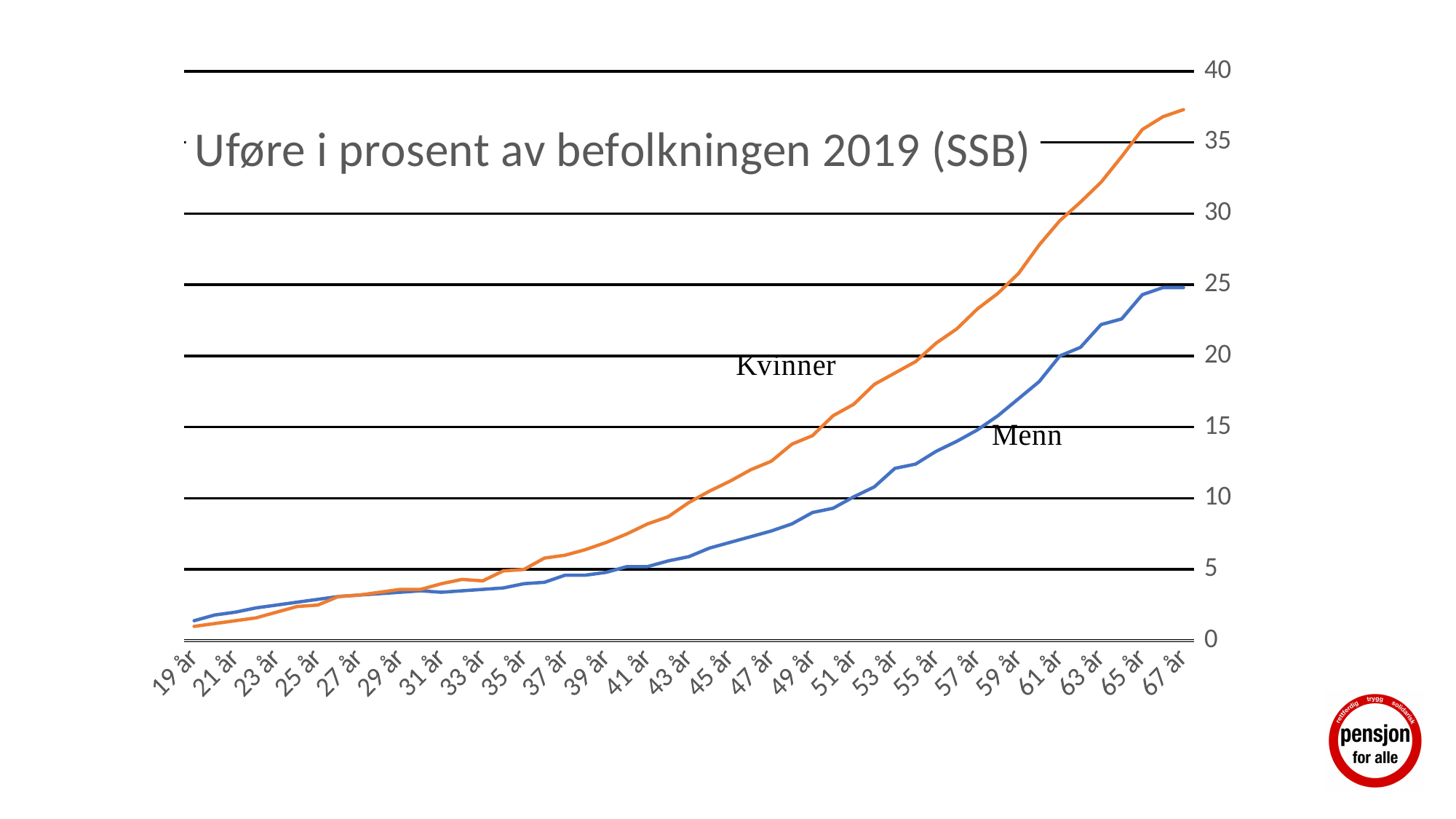
Do the values for Kvinner rise or fall as age increases along the x axis? rise Is the value for Menn at 35 år greater or less than 5? less Is the value for Kvinner at 47 år greater or less than 10? greater At 55 år, which series has the higher value, Kvinner or Menn? Kvinner What kind of chart is shown on the slide? line chart Which colour is the Kvinner line? orange Is the value for Kvinner at 67 år greater or less than 35? greater What is the title of the chart? Uføre i prosent av befolkningen 2019 (SSB) How many series are plotted in the chart? 2